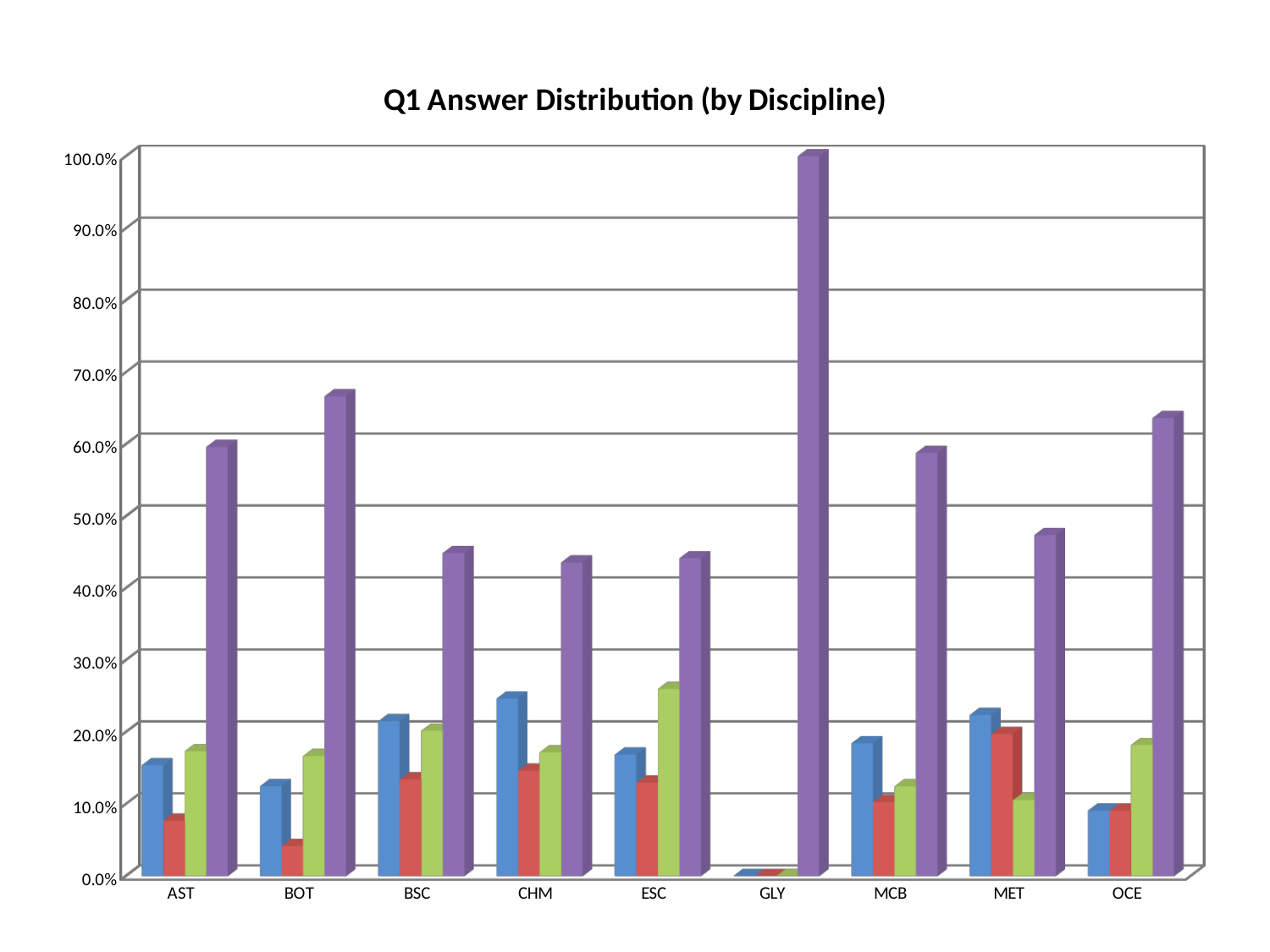
How many disciplines are shown along the x axis? 9 Which discipline has the tallest purple bar? GLY How many differently coloured bars are shown for each discipline? 4 Is the red bar for BOT greater or less than 10%? less What kind of chart is shown on the slide? bar chart Is the purple bar for MET greater or less than 50%? less Is the purple bar for BOT greater or less than 60%? greater Which has the taller purple bar, BOT or AST? BOT What value does the purple bar for GLY reach? 100.0% What is the title of the chart? Q1 Answer Distribution (by Discipline)